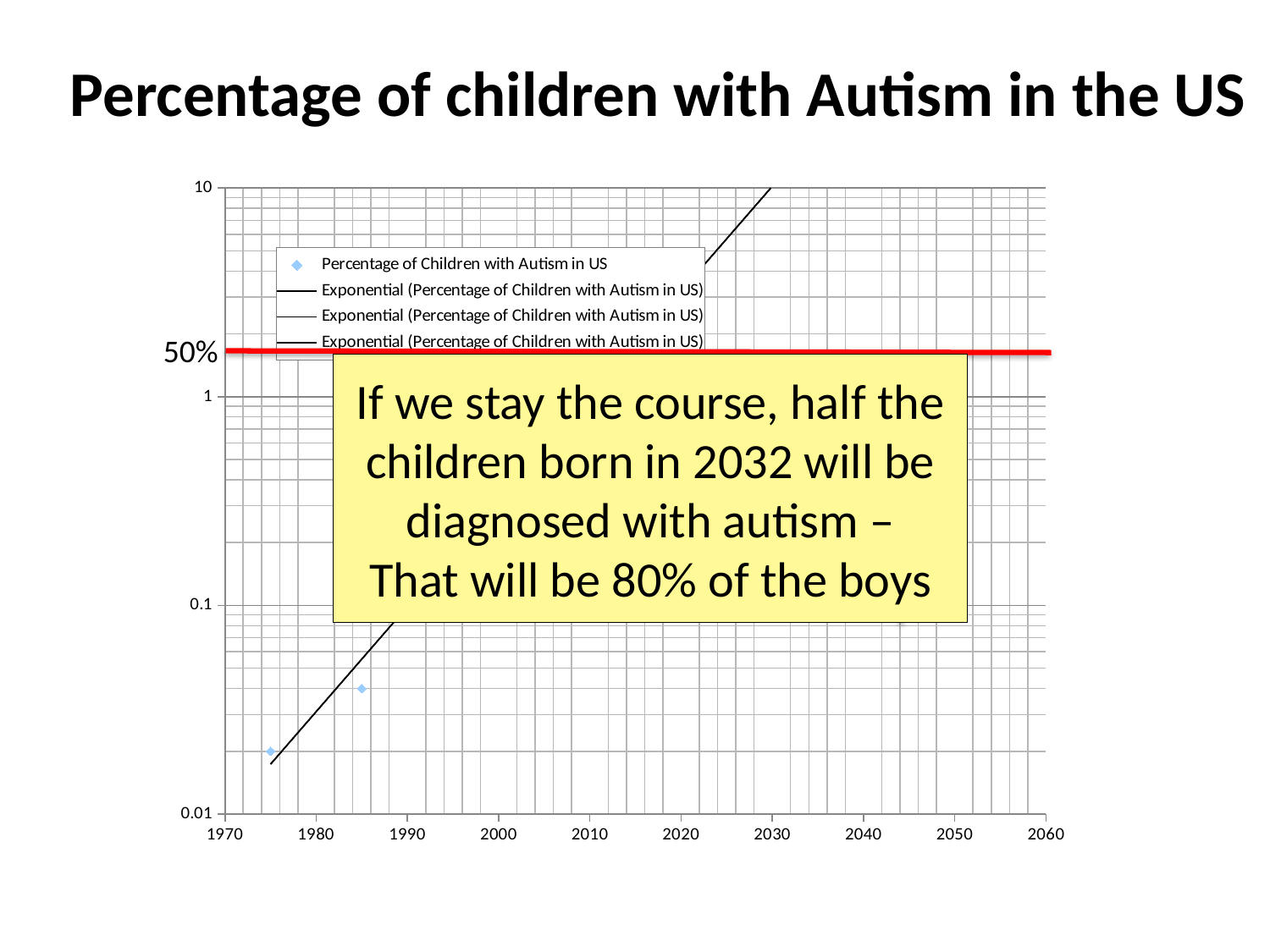
What is the title of the slide's chart? Percentage of children with Autism in the US Do the plotted values rise or fall as the year increases along the x axis? rise Is the plotted value for 1985 greater or less than 0.1? less What kind of chart is shown on the slide? scatter chart What is the lowest tick label on the y axis? 0.01 What is the highest tick label on the y axis? 10 Is the plotted value for 1985 greater or less than 0.01? greater How many entries does the chart legend list? 4 Which plotted point is higher, the one at 1975 or the one at 1985? 1985 Is the plotted value for 1975 greater or less than 0.1? less